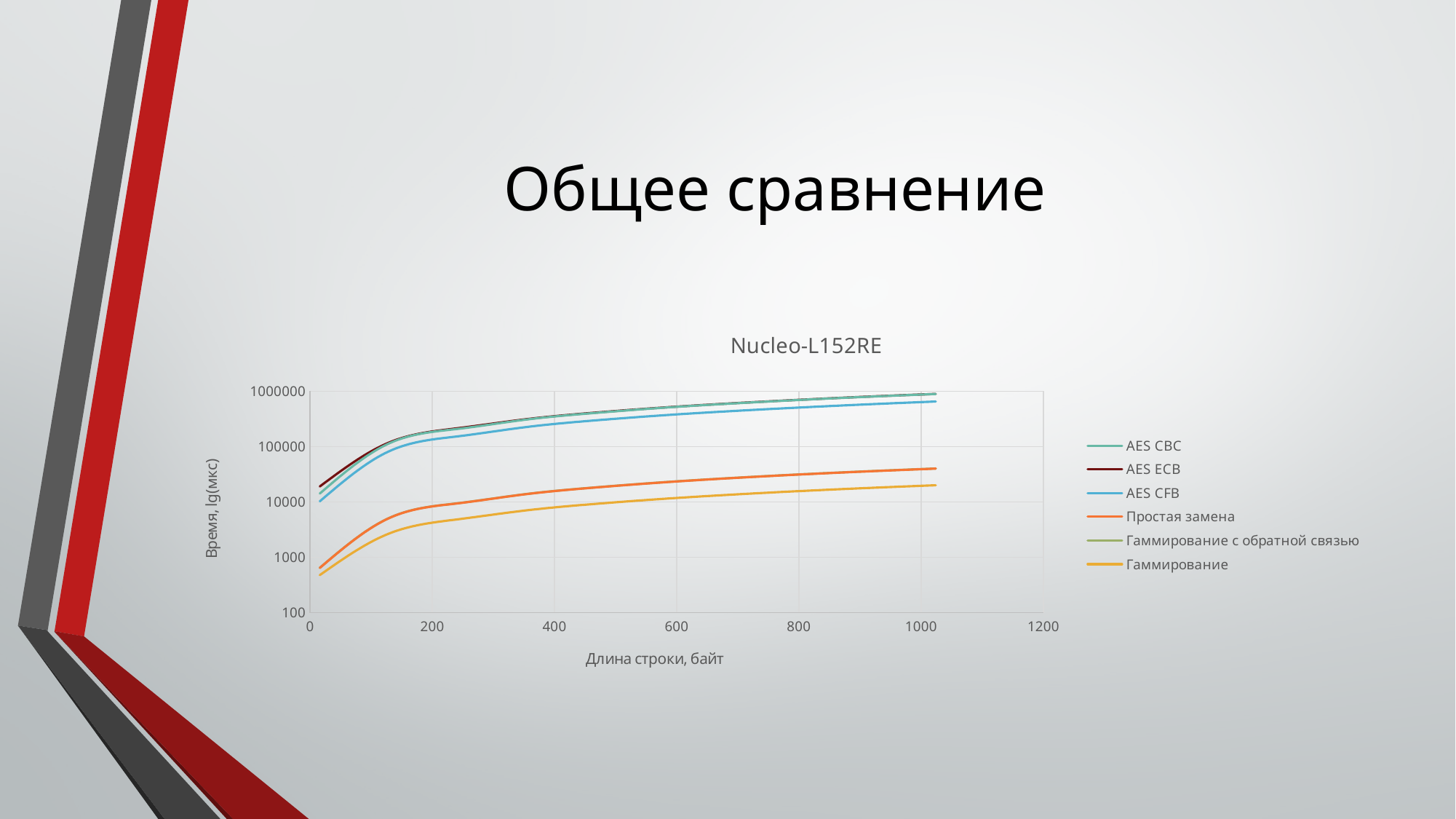
Do the values of the AES CFB series rise or fall as the string length increases along the x axis? rise How many series does the legend of the chart list? 6 What kind of chart is shown on the slide? line chart What is the title of the chart? Nucleo-L152RE Which series has the lowest values across the whole chart? Гаммирование What is the label of the vertical axis of the chart? Время, lg(мкс) Is the value for Гаммирование at a string length of 1000 bytes greater or less than 100000? less Is the value for Простая замена at a string length of 200 bytes greater or less than 1000? greater At a string length of 600 bytes, which series has the larger value: Простая замена or Гаммирование? Простая замена Is the value for Гаммирование at a string length of 200 bytes greater or less than 10000? less At a string length of 1000 bytes, which series has the larger value: AES CFB or Простая замена? AES CFB